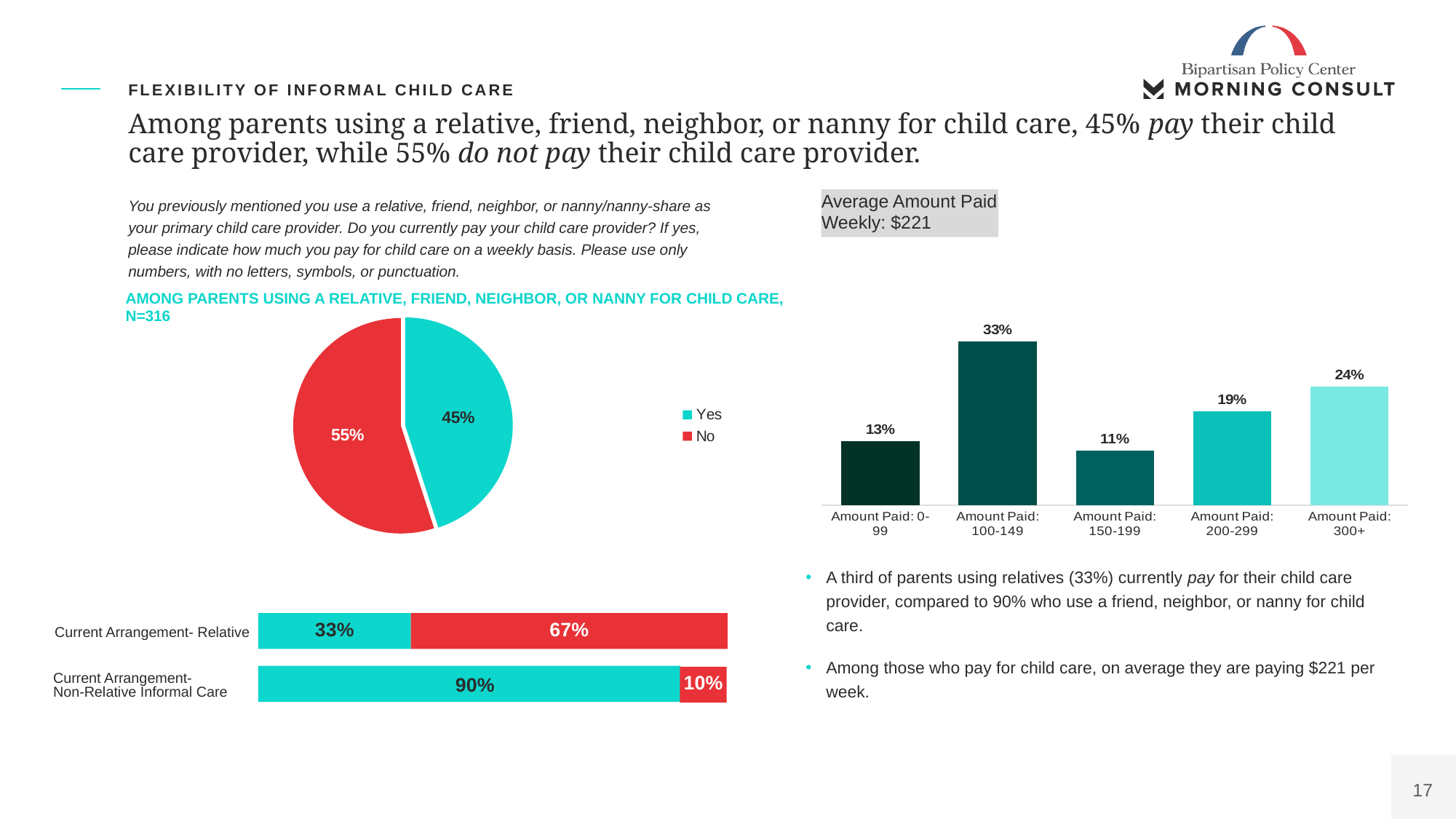
In the bar chart on the right showing amount paid, which category has the lowest value? Amount Paid: 150-199 In the pie chart on the left, what share of parents answered Yes to paying their child care provider? 45% How many series does the legend of the pie chart on the left list? 2 In the bar chart on the right showing amount paid, which category has the highest value? Amount Paid: 100-149 In the pie chart on the left, what share of parents answered No? 55% In the stacked bar chart at the bottom left, what is the Yes value for Current Arrangement- Non-Relative Informal Care? 90% In the bar chart on the right showing amount paid, how many categories are shown? 5 In the stacked bar chart at the bottom left, what is the total of the Current Arrangement- Relative bar? 100% In the bar chart on the right showing amount paid, what is the difference between Amount Paid: 300+ and Amount Paid: 200-299? 5% In the bar chart on the right showing amount paid, what is the value for Amount Paid: 100-149? 33% In the bar chart on the right showing amount paid, which is larger: Amount Paid: 0-99 or Amount Paid: 150-199? Amount Paid: 0-99 What type of chart is the chart on the left showing Yes and No responses? Pie chart